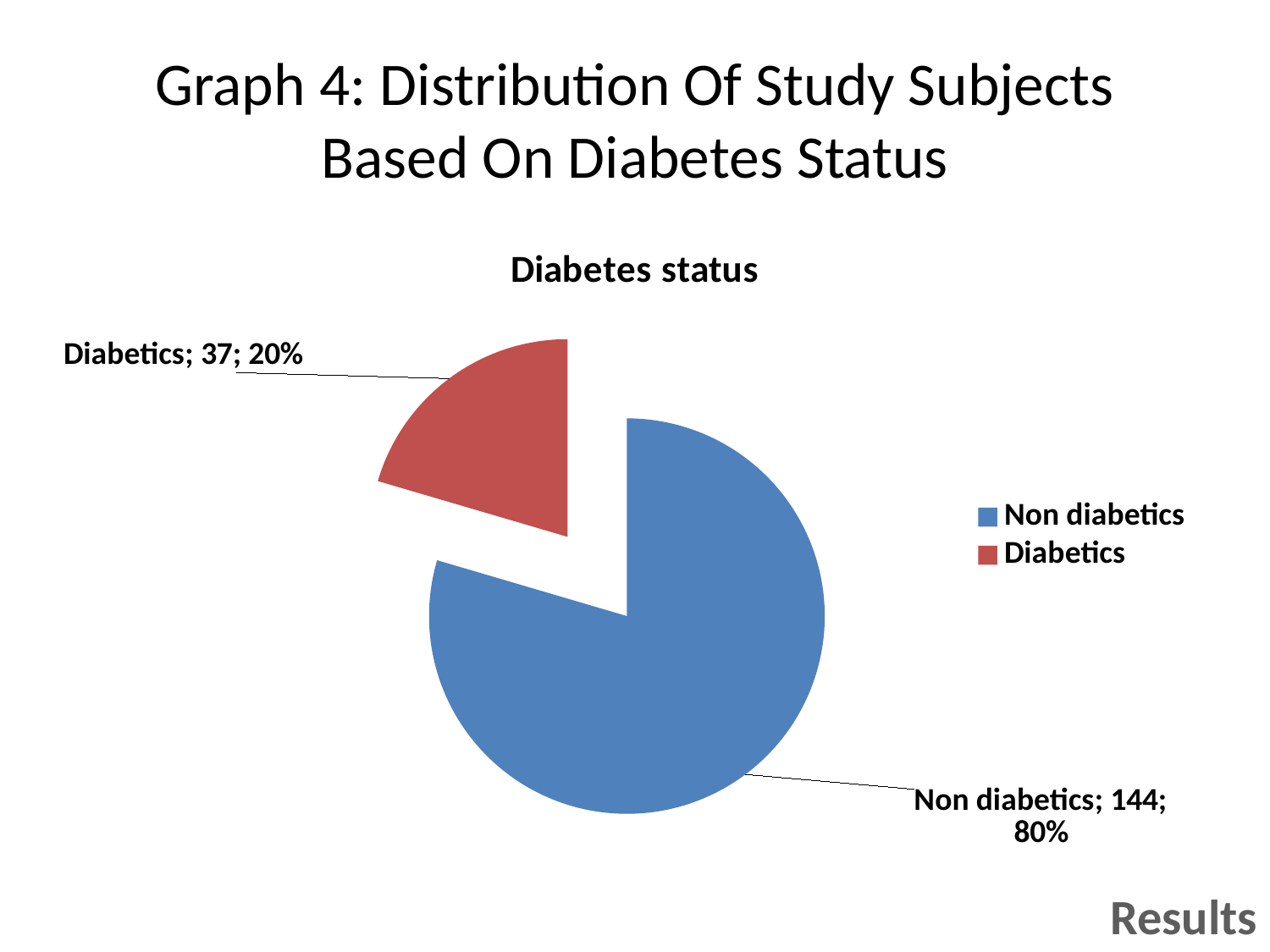
What kind of chart is shown on the slide? pie chart What percentage of the pie is the Diabetics slice? 20% What percentage of the pie is the Non diabetics slice? 80% Which category has the largest slice? Non diabetics How many categories does the pie chart have? 2 What is the title of the pie chart? Diabetes status What is the difference between the number of Non diabetics and Diabetics? 107 Which category has the smallest slice? Diabetics How many subjects are Diabetics? 37 Which is larger, the Diabetics slice or the Non diabetics slice? Non diabetics How many subjects are Non diabetics? 144 What is the total number of study subjects shown in the pie chart? 181